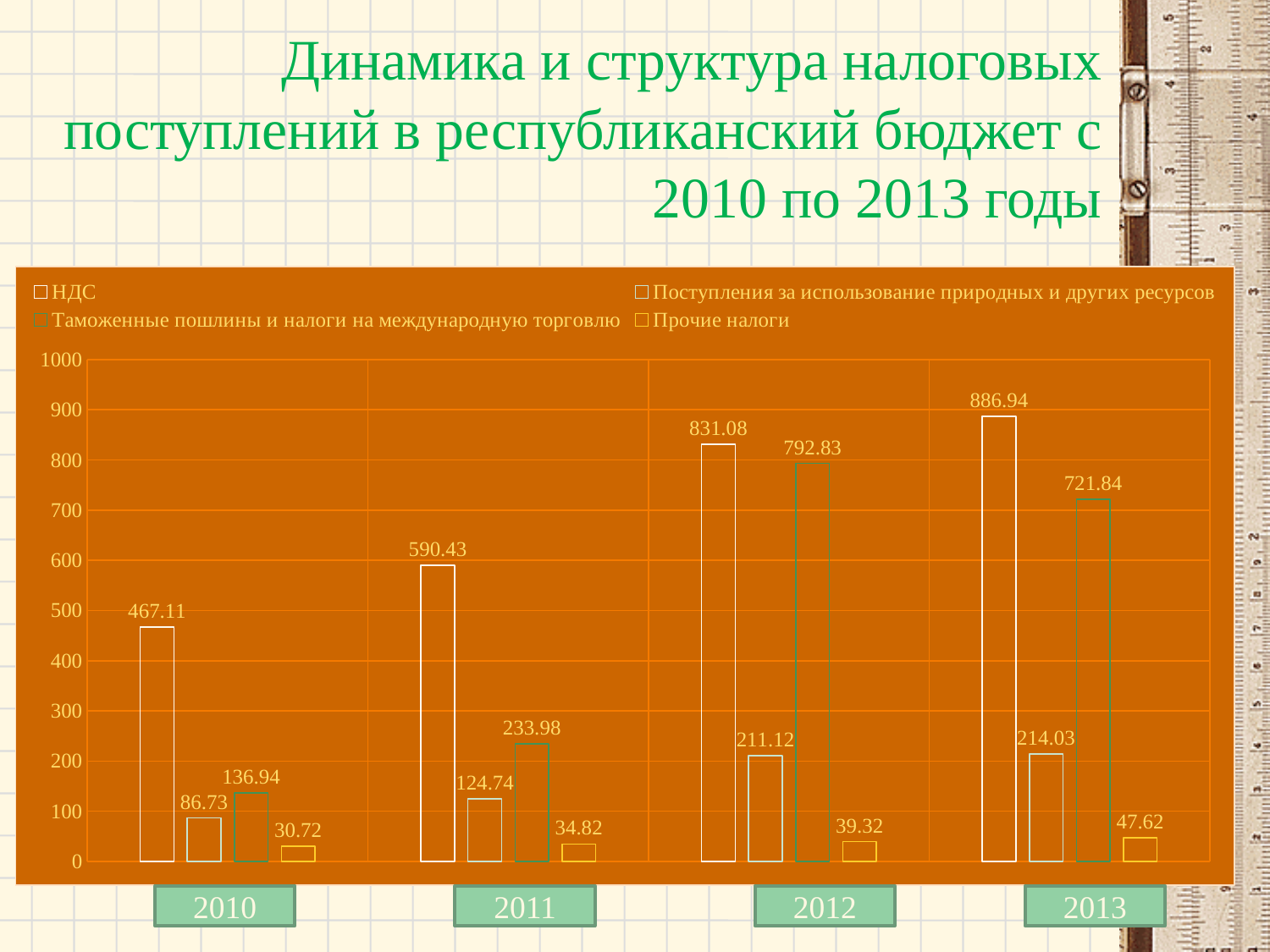
What is the difference between the НДС values for 2013 and 2012? 55.86 Which is larger in 2012: НДС or Таможенные пошлины и налоги на международную торговлю? НДС In which year is the Прочие налоги value lowest? 2010 What is the value of Поступления за использование природных и других ресурсов for 2011? 124.74 How many years are shown on the x axis? 4 In which year is the НДС value highest? 2013 What is the value of Таможенные пошлины и налоги на международную торговлю for 2012? 792.83 Does the НДС value rise or fall from 2010 to 2013? Rises What kind of chart is shown on the slide? Bar chart How many series does the legend list? 4 What is the value of НДС for 2013? 886.94 What is the value of Прочие налоги for 2010? 30.72